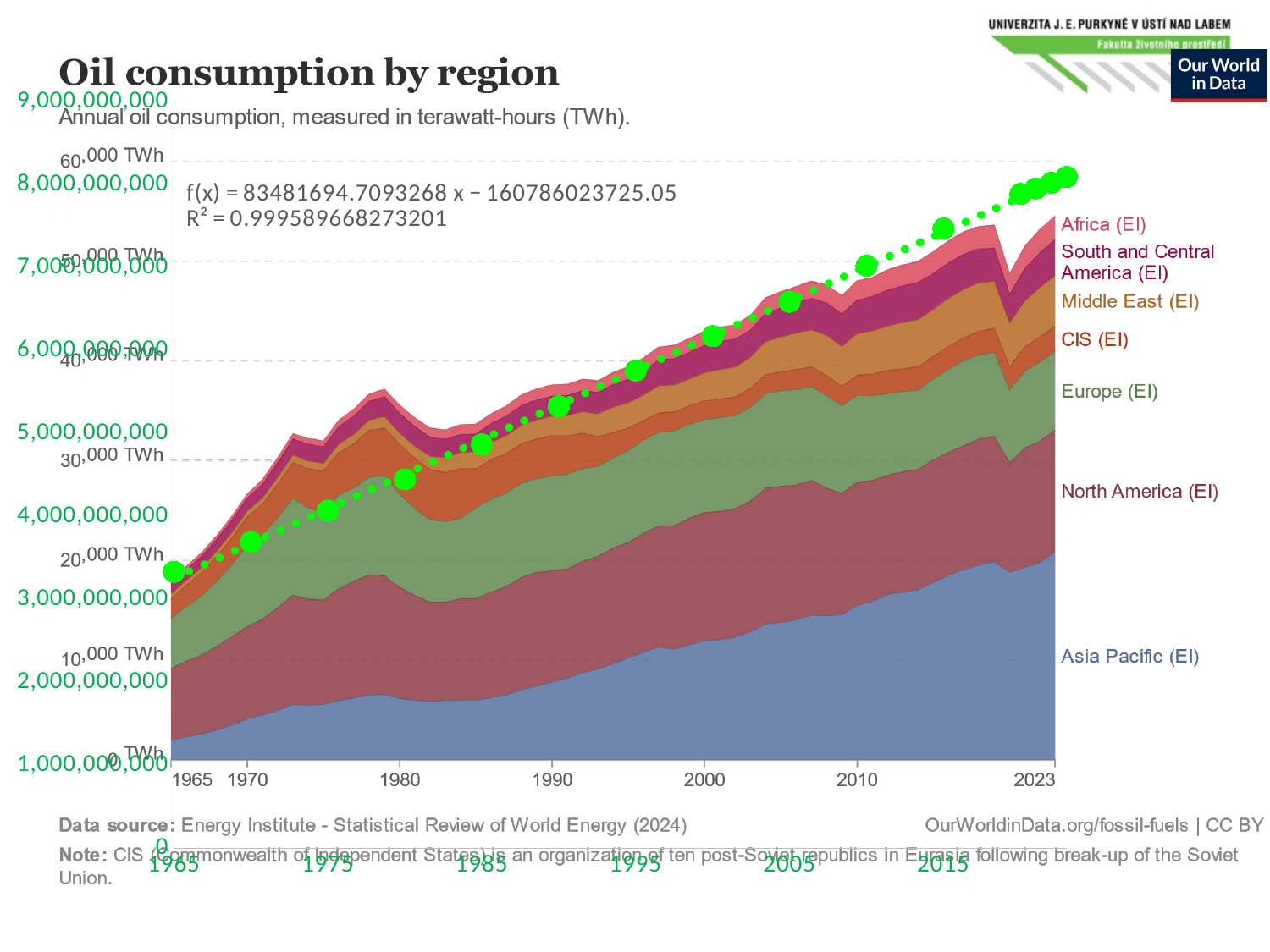
Which region forms the bottom layer of the stacked area chart? Asia Pacific (EI) Is the total oil consumption in 1965 greater or less than 30,000 TWh? less In 2023, is oil consumption for Asia Pacific (EI) larger or smaller than for Europe (EI)? larger What is the intercept in the trendline equation f(x) shown on the slide? −160786023725.05 What data source is cited for the oil consumption by region chart? Energy Institute - Statistical Review of World Energy (2024) Does total oil consumption generally rise or fall from 1965 to 2023? rise What is the R² value shown for the green trendline? 0.999589668273201 What kind of chart is used to show oil consumption by region? stacked area chart How many regions are shown in the oil consumption by region chart? 7 What is the slope (coefficient of x) in the trendline equation f(x) shown on the slide? 83481694.7093268 Which region has the largest oil consumption in 2023 in the stacked area chart? Asia Pacific (EI) Is the total oil consumption in 2023 greater or less than 50,000 TWh? greater